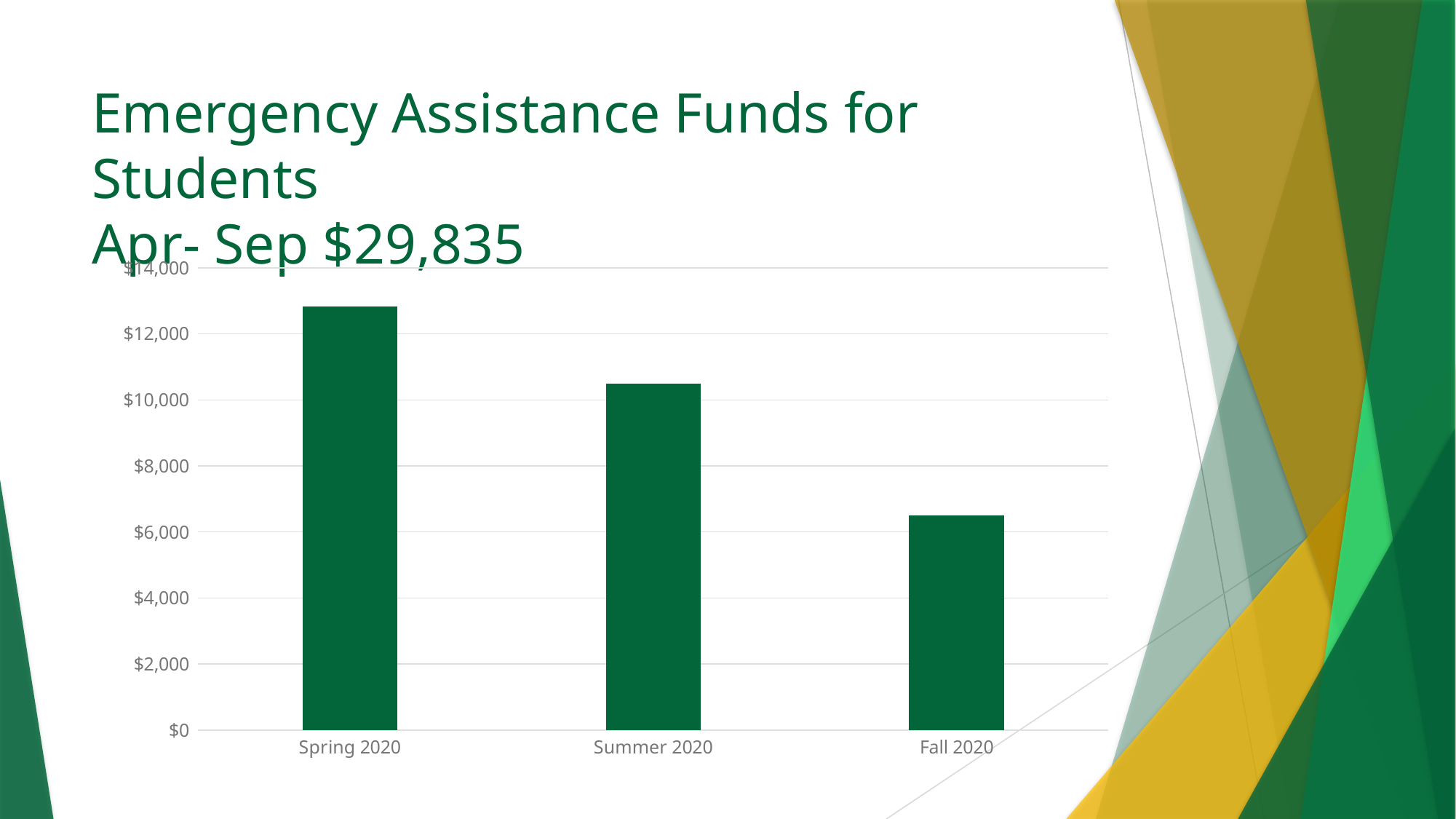
How many categories are shown on the x axis of the chart? 3 Is the value for Fall 2020 greater or less than $8,000? less Which is larger, the value for Spring 2020 or the value for Summer 2020? Spring 2020 Which category has the lowest bar in the chart? Fall 2020 Which category has the highest bar in the chart? Spring 2020 Which is larger, the value for Summer 2020 or the value for Fall 2020? Summer 2020 What total amount for Apr- Sep is stated in the slide title? $29,835 Is the value for Spring 2020 greater or less than $12,000? greater Do the values rise or fall from Spring 2020 to Fall 2020 along the x axis? fall Is the value for Summer 2020 greater or less than $10,000? greater What is the highest value labelled on the y axis of the chart? $14,000 What kind of chart is shown on the slide? bar chart